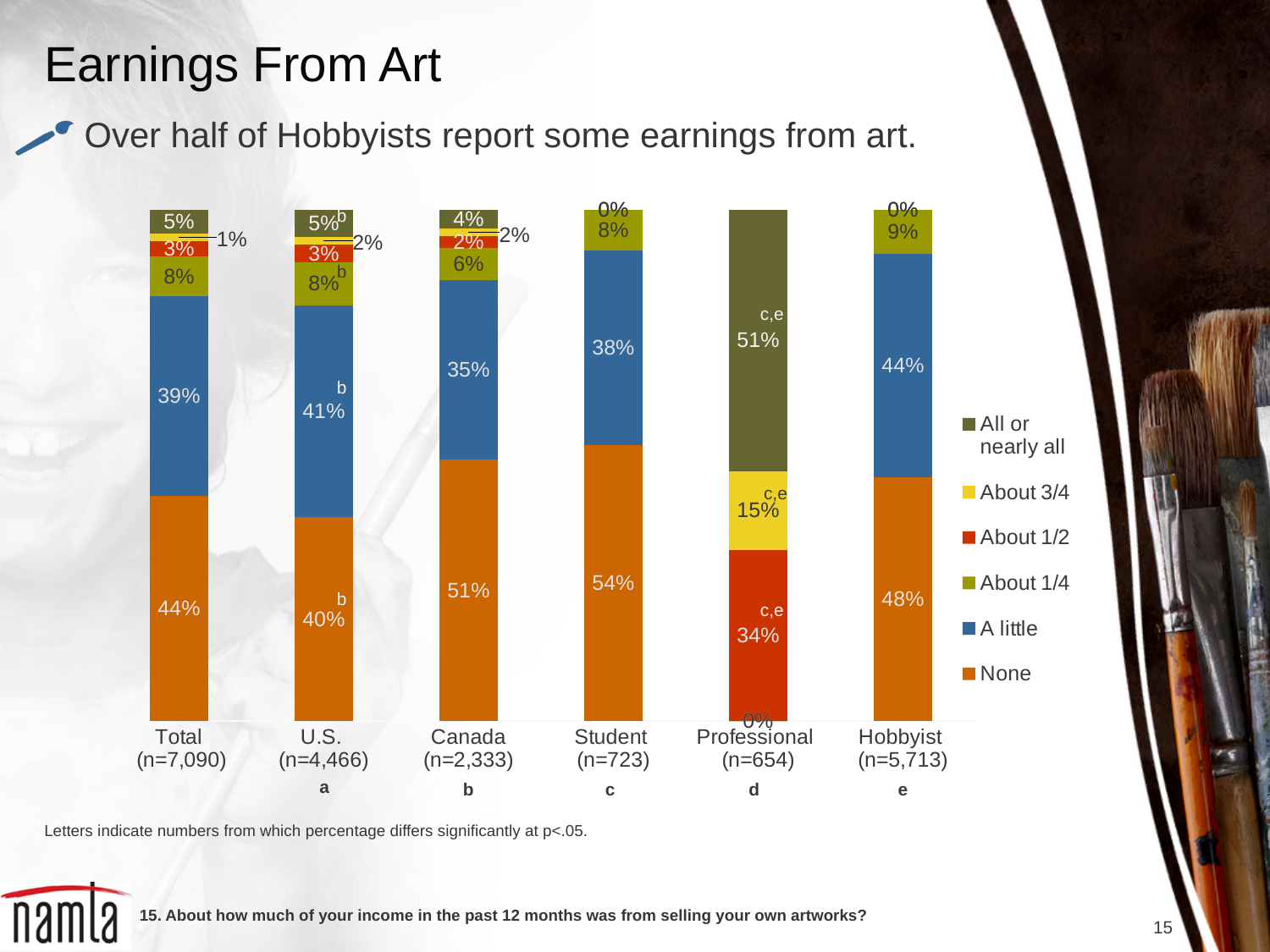
What percentage of Professionals (n=654) report 'All or nearly all' of their income from art? 51% What percentage of Hobbyists (n=5,713) report 'None' earnings from art? 48% What kind of chart is shown on the slide? Stacked bar chart What is the difference between the 'None' percentage for Canada and for U.S.? 11% Which is larger, the 'A little' value for Hobbyist or for Student? Hobbyist What is the 'A little' value for Canada (n=2,333)? 35% Which legend entry is shown in blue? A little How many categories are shown along the x axis? 6 What is the 'About 1/2' value for Professional (n=654)? 34% How many series does the legend list? 6 Which category has the highest 'None' percentage? Student (n=723) Which category has the lowest 'None' percentage? Professional (n=654)